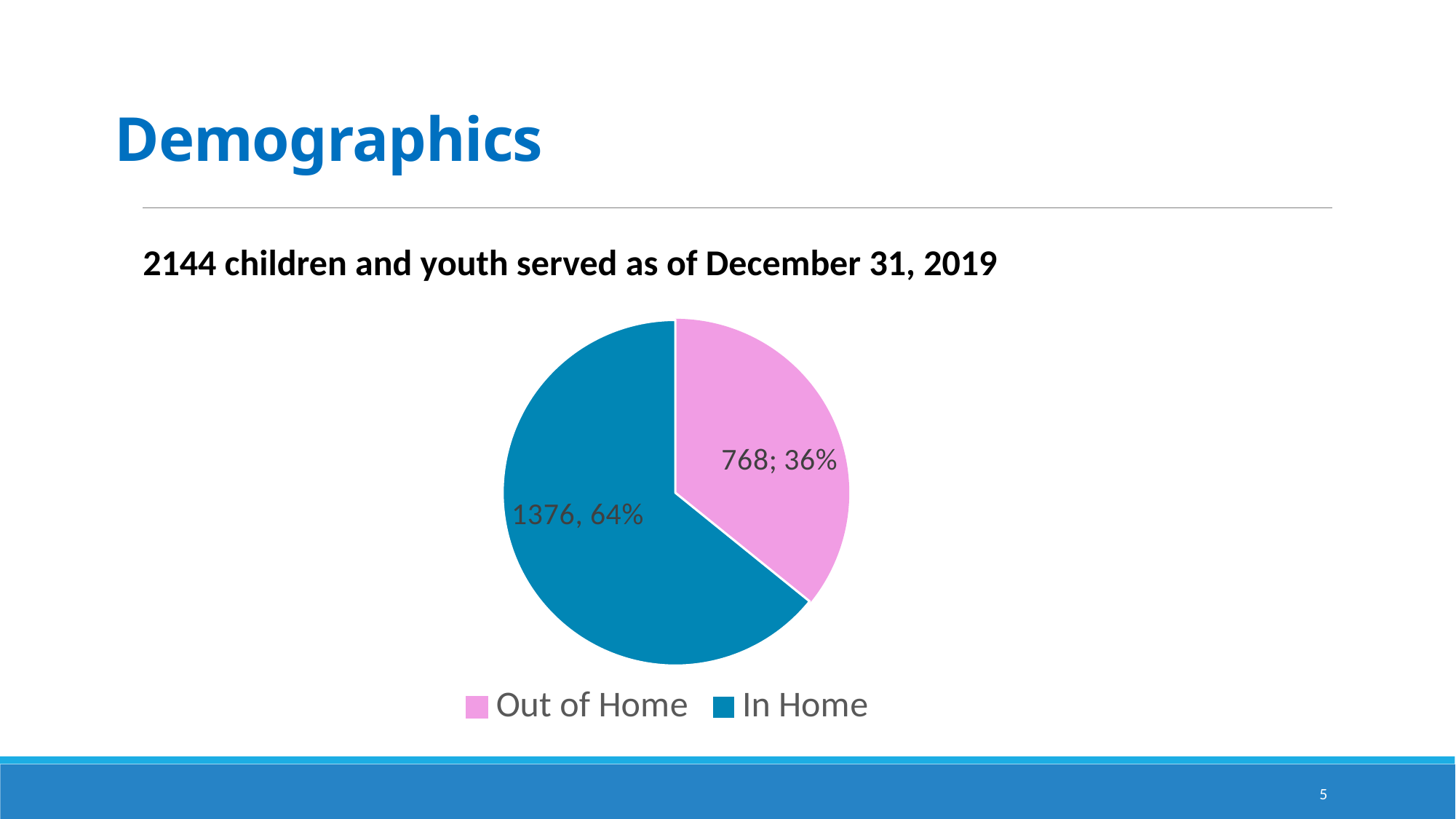
What colour is the Out of Home slice? pink What type of chart is shown on the slide? pie chart How many categories does the pie chart have? 2 Which is larger, the Out of Home count or the In Home count? In Home How many children and youth are in the Out of Home category? 768 Which category has the smallest slice of the pie? Out of Home What percentage of the pie does the Out of Home slice represent? 36% What is the total of the two slices in the pie chart? 2144 Which category has the largest slice of the pie? In Home What is the difference between the In Home and Out of Home counts? 608 What percentage of the pie does the In Home slice represent? 64% How many children and youth are in the In Home category? 1376